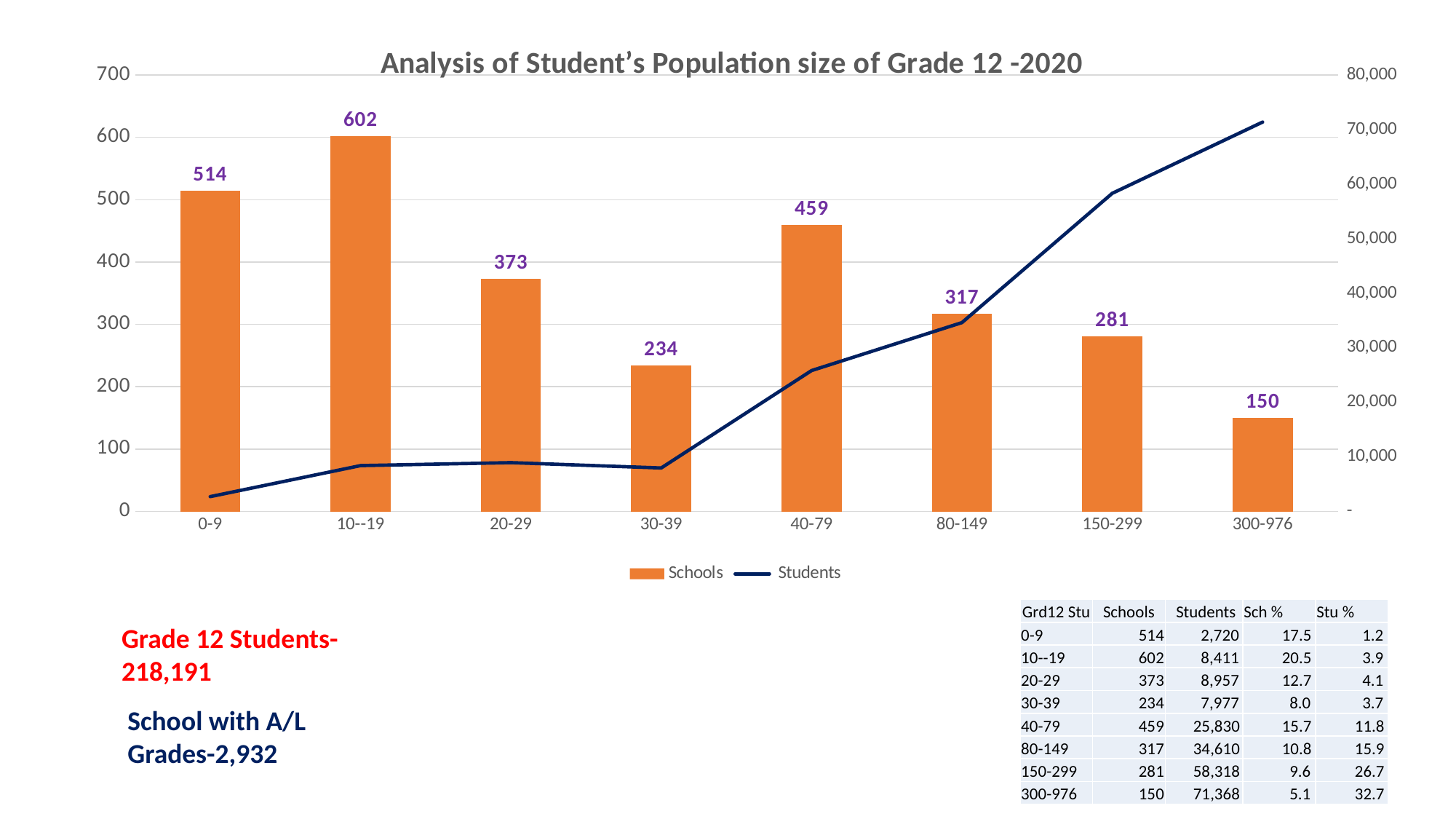
What is the difference in Schools between the 10--19 and 0-9 categories? 88 What is the number of Schools for the 10--19 category? 602 What is the title of the chart? Analysis of Student’s Population size of Grade 12 -2020 How many categories are shown on the x axis? 8 Is the Students value for the 300-976 category greater or less than 60,000? greater Which has more Schools, the 40-79 category or the 20-29 category? 40-79 How many series does the legend list? 2 Is the Students value for the 30-39 category greater or less than 10,000? less What is the number of Schools for the 300-976 category? 150 Does the Students line generally rise or fall from the 30-39 category to the 300-976 category? rise Which category has the highest number of Schools? 10--19 Which category has the lowest number of Schools? 300-976